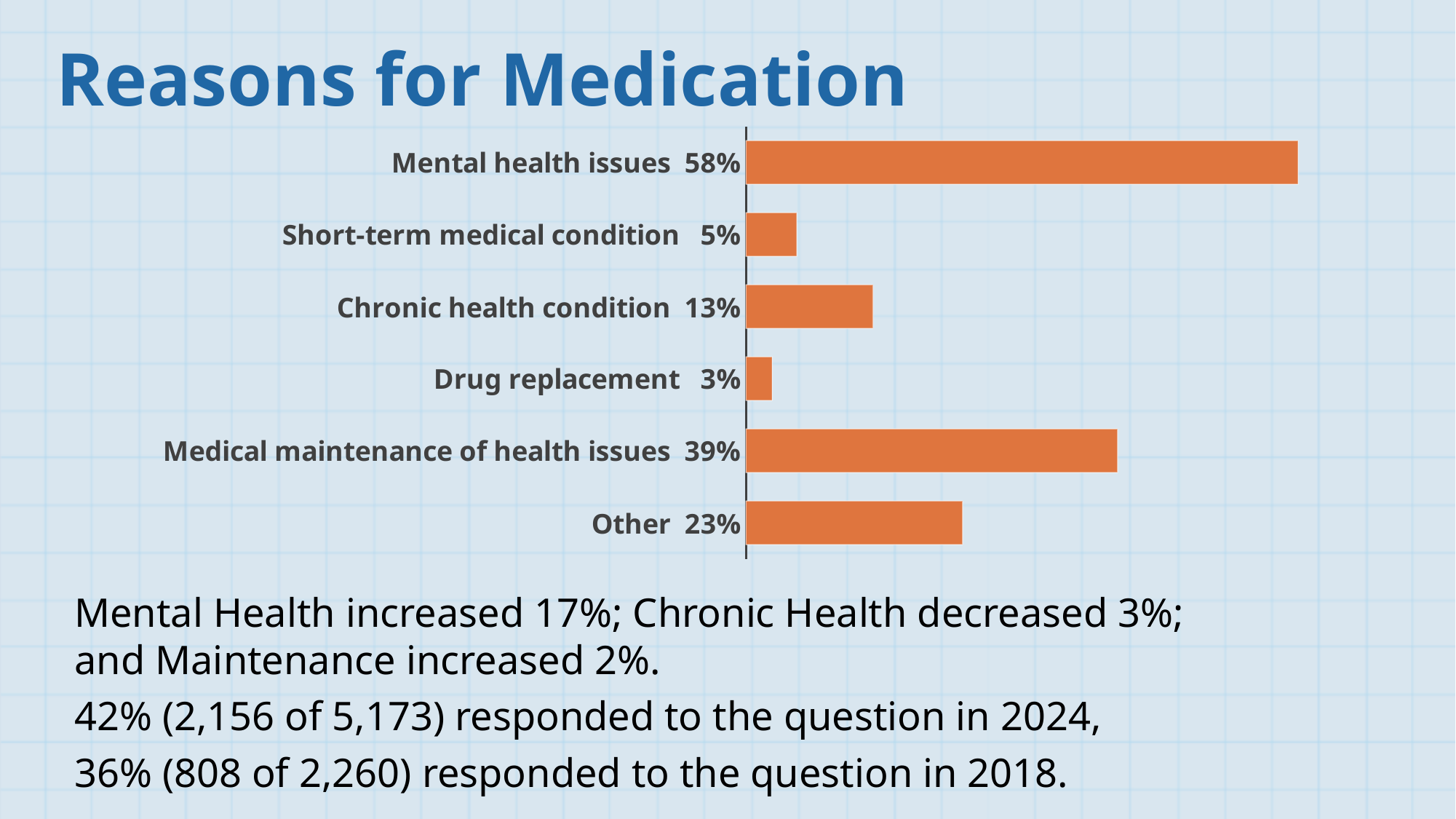
Which reason for medication has the highest percentage? Mental health issues How many reasons for medication are shown in the chart? 6 Which reason for medication has the lowest percentage? Drug replacement What percentage is shown for Drug replacement? 3% Which is larger, the value for Chronic health condition or the value for Other? Other What is the title of the slide? Reasons for Medication What is the difference in percentage points between Mental health issues and Medical maintenance of health issues? 19 What percentage is shown for Mental health issues? 58% What kind of chart is shown on the slide? Bar chart What is the difference in percentage points between Chronic health condition and Short-term medical condition? 8 What percentage is shown for Other? 23% What percentage is shown for Medical maintenance of health issues? 39%